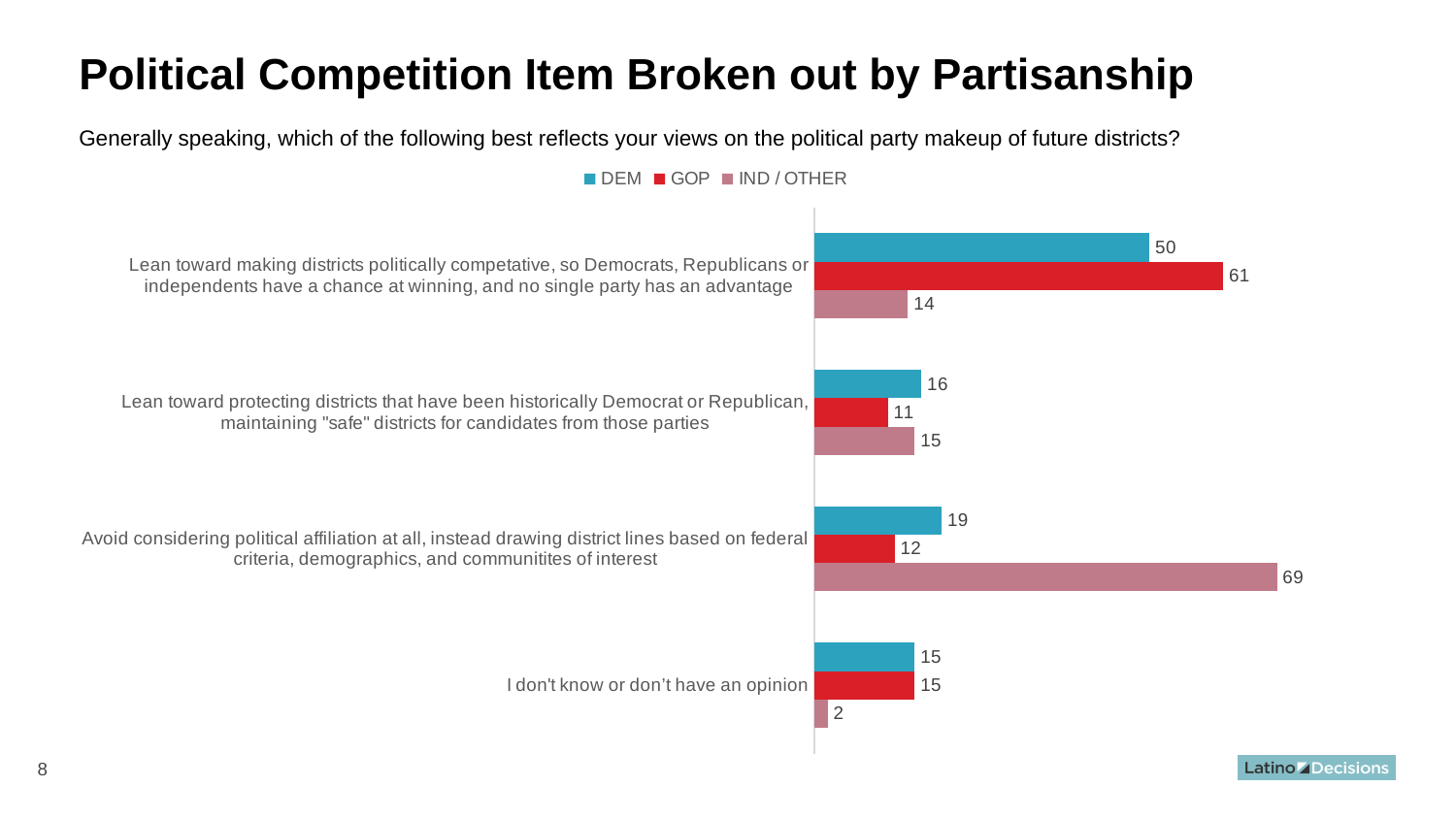
What is the DEM value for "Lean toward protecting districts that have been historically Democrat or Republican, maintaining "safe" districts for candidates from those parties"? 16 What is the difference between the GOP and DEM values for "Lean toward making districts politically competative, so Democrats, Republicans or independents have a chance at winning, and no single party has an advantage"? 11 Which is larger for "Avoid considering political affiliation at all, instead drawing district lines based on federal criteria, demographics, and communitites of interest": the DEM value or the GOP value? DEM Which series is shown in red in the legend? GOP What is the GOP value for "Lean toward making districts politically competative, so Democrats, Republicans or independents have a chance at winning, and no single party has an advantage"? 61 How many series does the legend list? 3 Which category has the lowest IND / OTHER value? I don't know or don't have an opinion What is the IND / OTHER value for "I don't know or don't have an opinion"? 2 Which category has the highest DEM value? Lean toward making districts politically competative, so Democrats, Republicans or independents have a chance at winning, and no single party has an advantage How many categories are shown on the chart? 4 What is the IND / OTHER value for "Avoid considering political affiliation at all, instead drawing district lines based on federal criteria, demographics, and communitites of interest"? 69 What kind of chart is shown on the slide? Bar chart